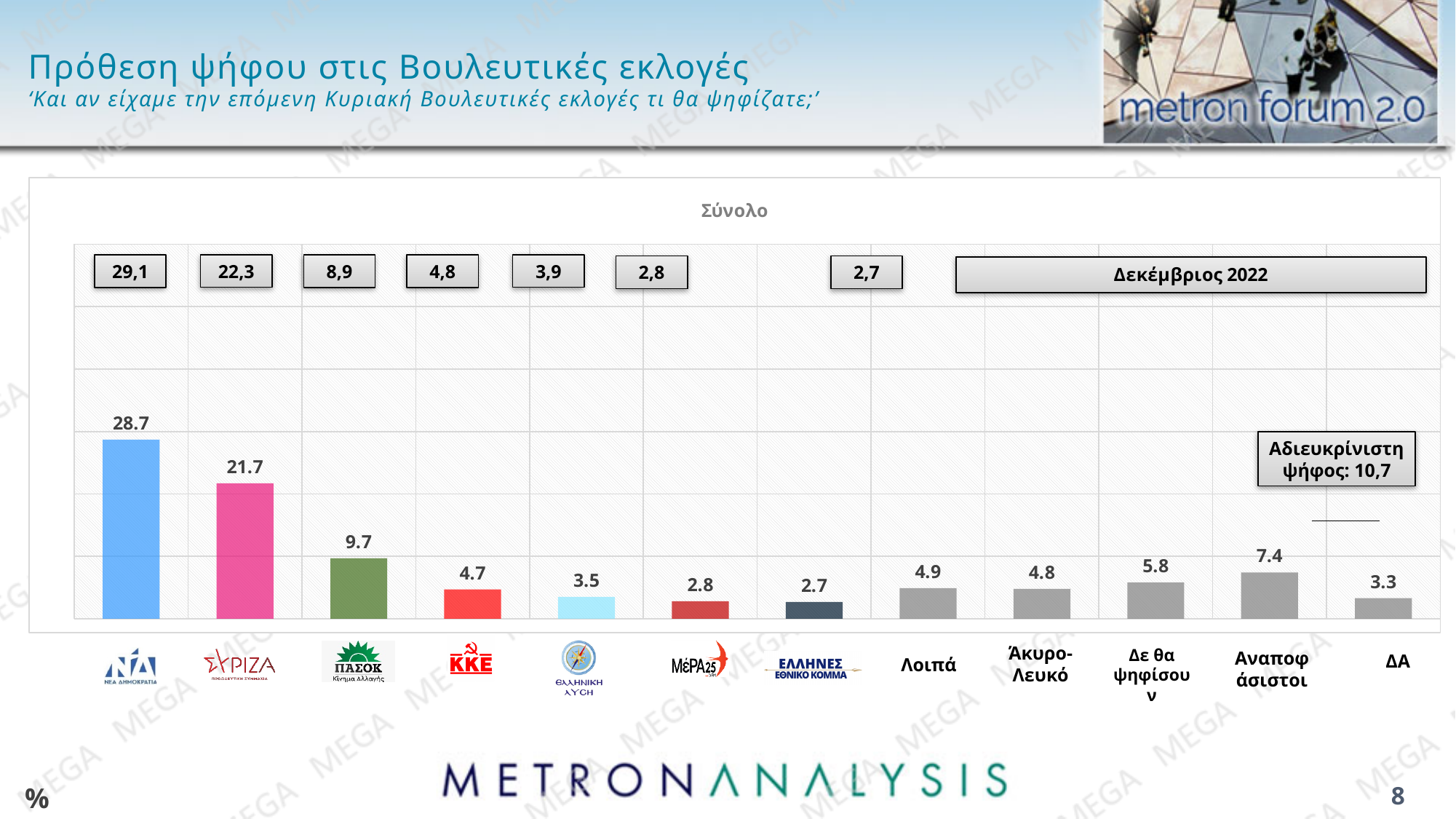
What is the value of the bar for ΔΑ? 3.3 Which is larger, the bar for Δε θα ψηφίσουν or the bar for Λοιπά? Δε θα ψηφίσουν Which category has the lowest bar? ΕΛΛΗΝΕΣ ΕΘΝΙΚΟ ΚΟΜΜΑ What is the difference between the bars for ΝΕΑ ΔΗΜΟΚΡΑΤΙΑ and ΣΥΡΙΖΑ? 7.0 What is the value of the bar for ΠΑΣΟΚ? 9.7 Which category has the highest bar? ΝΕΑ ΔΗΜΟΚΡΑΤΙΑ What is the title shown above the chart? Σύνολο How many categories are shown on the x axis of the chart? 12 What is the value of the bar for ΚΚΕ? 4.7 What kind of chart is shown on the slide? Bar chart What value is given in the box labelled 'Αδιευκρίνιστη ψήφος'? 10,7 What is the value of the bar for Αναποφάσιστοι? 7.4